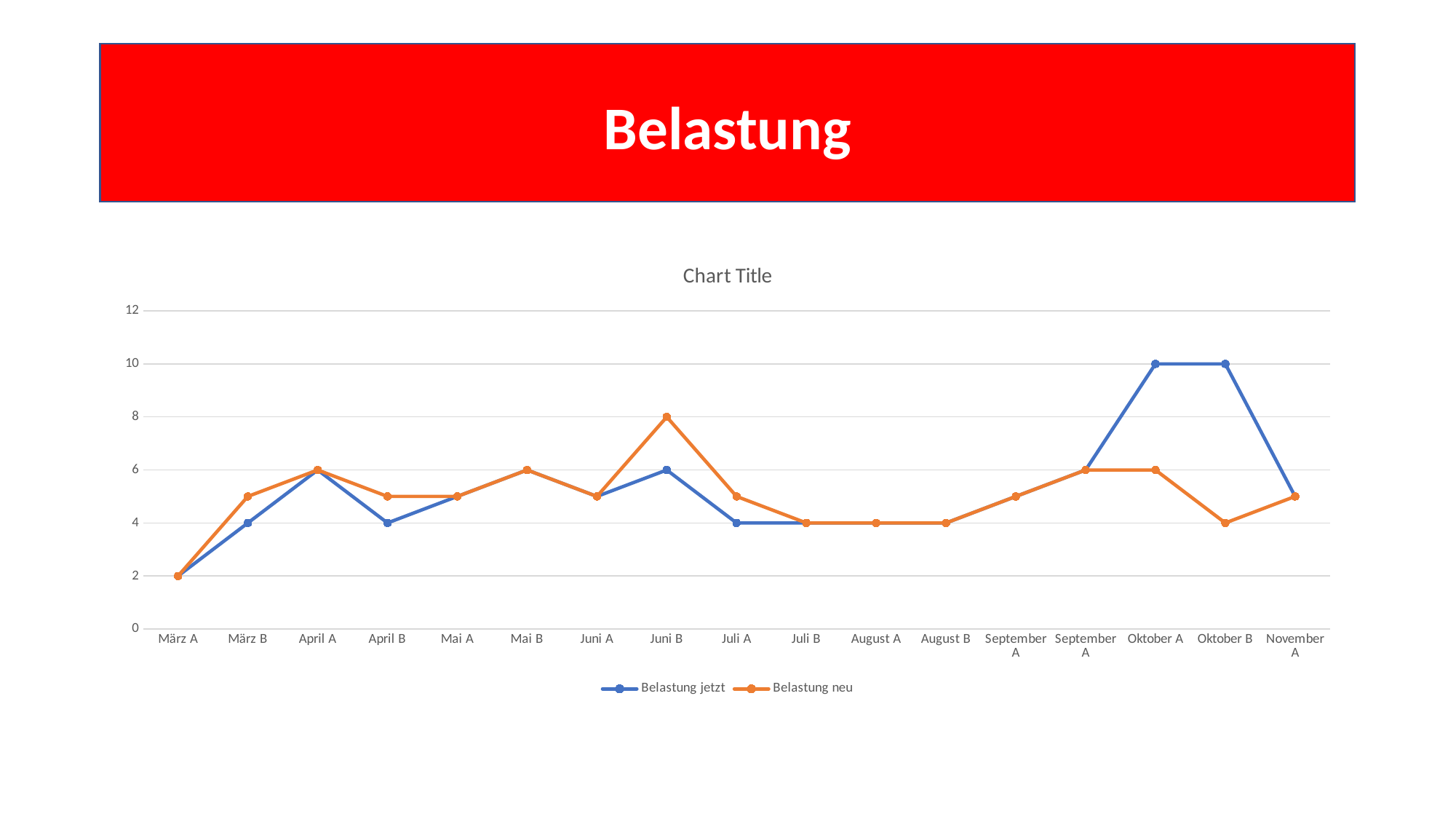
What is the difference between Belastung jetzt and Belastung neu at Oktober B? 6 How many categories are plotted along the x axis? 17 What is the value of Belastung jetzt at Oktober A? 10 At which category does Belastung neu reach its highest value? Juni B What kind of chart is shown on the slide? line chart Is the value for Belastung neu at März B greater or less than 4? greater At which category does Belastung jetzt have its lowest value? März A At Juni B, which series has the higher value, Belastung jetzt or Belastung neu? Belastung neu What is the value of Belastung neu at Oktober B? 4 What is the value of Belastung neu at Juni B? 8 How many series does the legend list? 2 What are the two legend entries of the chart? Belastung jetzt, Belastung neu